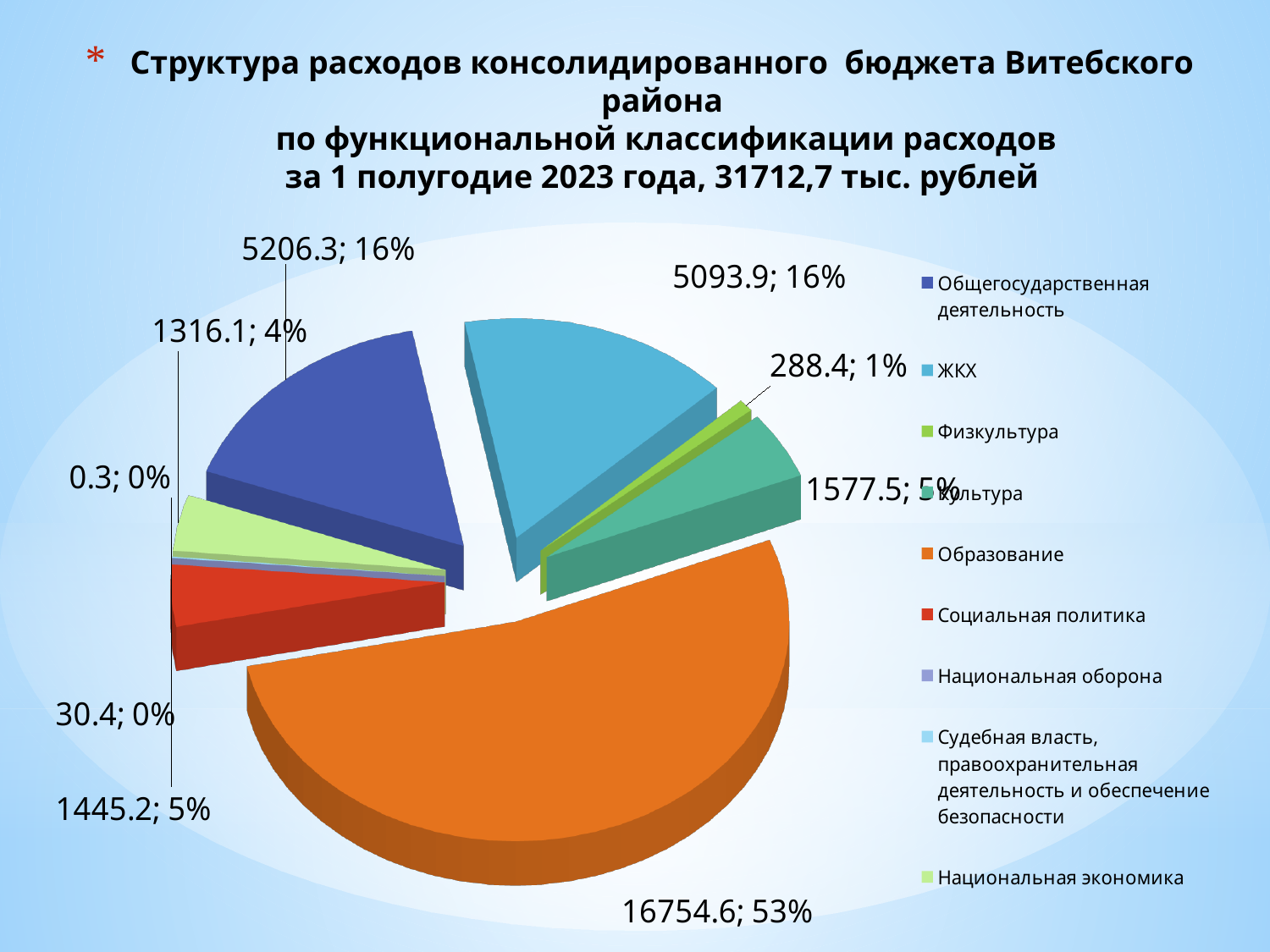
Which is larger, the value for Физкультура or the value for Национальная оборона? Физкультура What type of chart is shown on the slide? pie chart What share of the pie does Общегосударственная деятельность represent? 16% What share of the pie does Национальная экономика represent? 4% What value is shown for Социальная политика? 1445.2; 5% Which category has the largest slice of the pie? Образование What value is shown for Образование? 16754.6; 53% What is the difference between the values for Общегосударственная деятельность and ЖКХ? 112.4 Which category has the smallest value in the pie? Национальная оборона How many categories does the legend list? 9 What value is shown for ЖКХ? 5093.9; 16% What value is shown for Культура? 1577.5; 5%